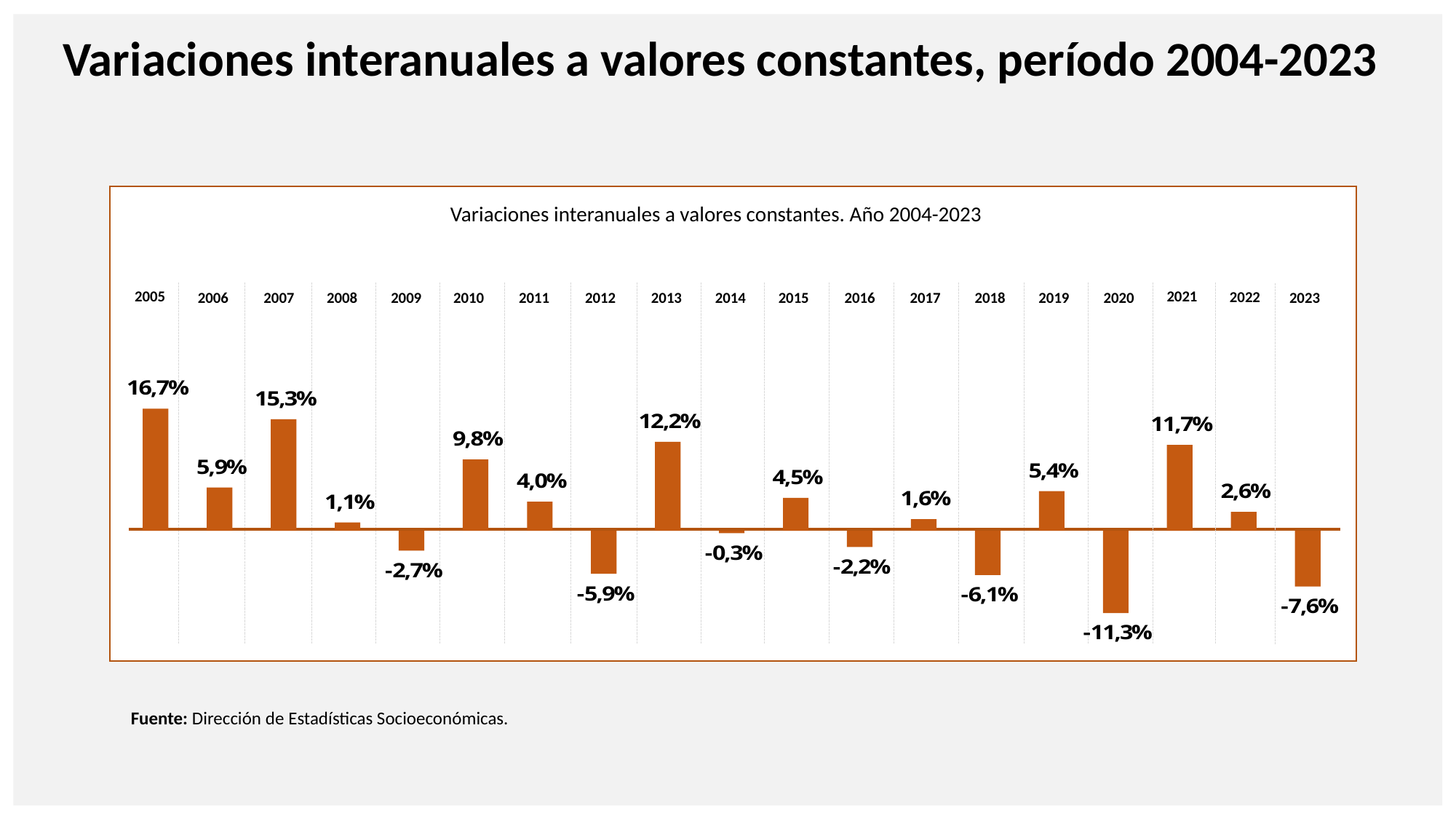
What is the title of the chart? Variaciones interanuales a valores constantes. Año 2004-2023 How many years are shown in the chart? 19 Which year has the lowest value? 2020 Which is larger, the value for 2010 or the value for 2021? 2021 What is the difference between the values for 2005 and 2007? 1,4% What is the value for 2014? -0,3% Which year has the highest value? 2005 What is the value for 2020? -11,3% What is the value for 2005? 16,7% What is the value for 2013? 12,2% What is the difference between the values for 2021 and 2022? 9,1% What kind of chart is this? bar chart